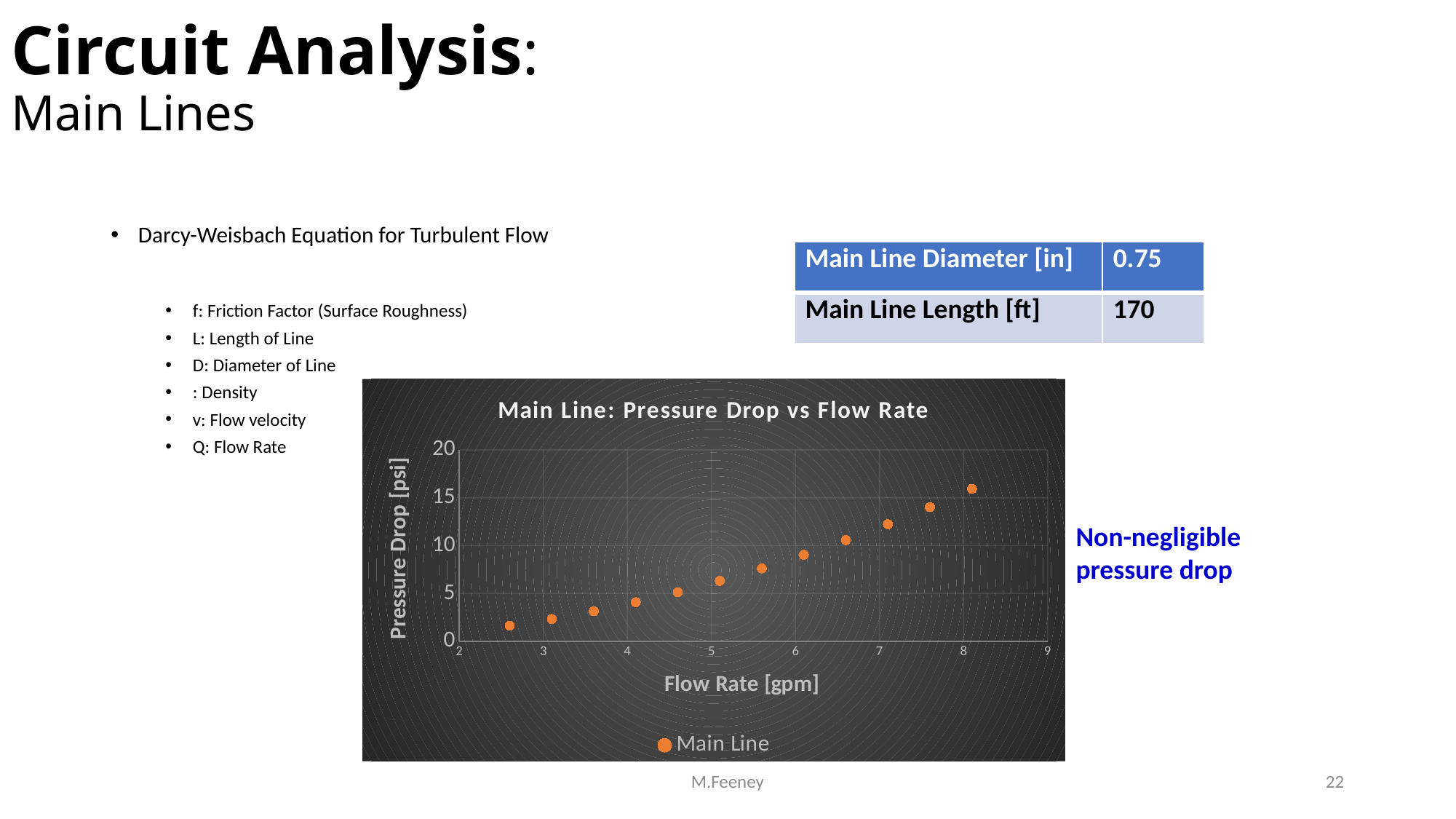
Is the pressure drop at a flow rate of about 4 gpm greater or less than 5 psi? less Is the pressure drop for the highest plotted flow rate (just above 8 gpm) greater or less than 10 psi? greater What kind of chart is shown on the slide? Scatter chart Is the pressure drop at a flow rate of about 7 gpm greater or less than 10 psi? greater Does the pressure drop rise or fall as flow rate increases along the x axis? Rise What is the label of the y axis? Pressure Drop [psi] How many series does the chart legend list? 1 What is the name of the series shown in the chart legend? Main Line Which plotted point has the highest pressure drop: the one at about 8 gpm or the one at about 3 gpm? The one at about 8 gpm How many data points are plotted in the chart? 12 What is the title of the chart? Main Line: Pressure Drop vs Flow Rate